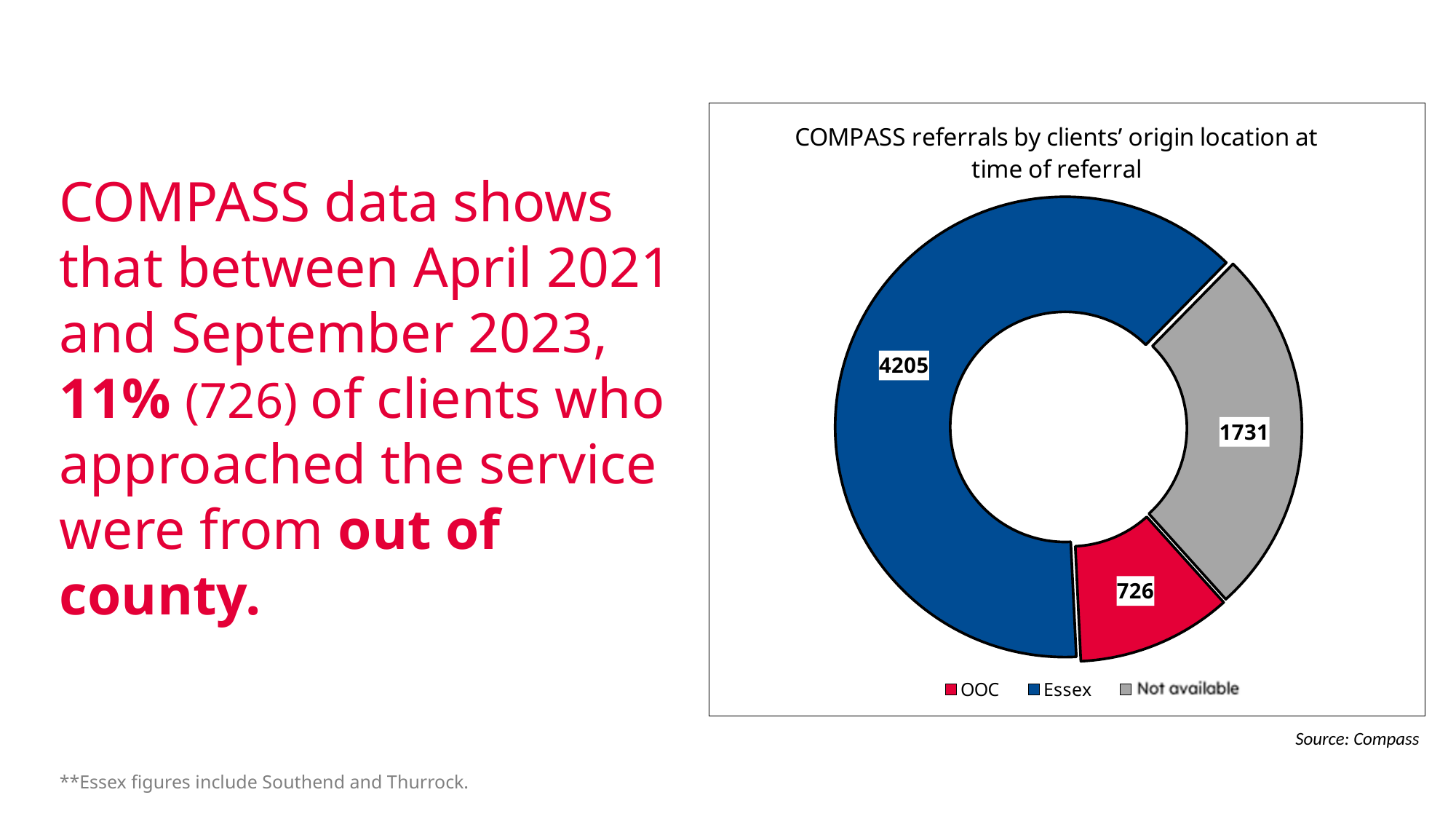
What is the number of COMPASS referrals for OOC? 726 What is the total number of referrals across all three categories? 6662 What is the difference between the Essex referrals and the Not available referrals? 2474 Which is larger, the number of referrals for Not available or for OOC? Not available Which origin location category has the highest number of referrals? Essex Which origin location category has the lowest number of referrals? OOC What is the number of COMPASS referrals for Essex? 4205 What is the number of COMPASS referrals where the origin location is Not available? 1731 What kind of chart is shown on the slide? doughnut chart What is the difference between the Not available referrals and the OOC referrals? 1005 How many categories does the chart show? 3 What share of all referrals does the OOC slice represent? 11%